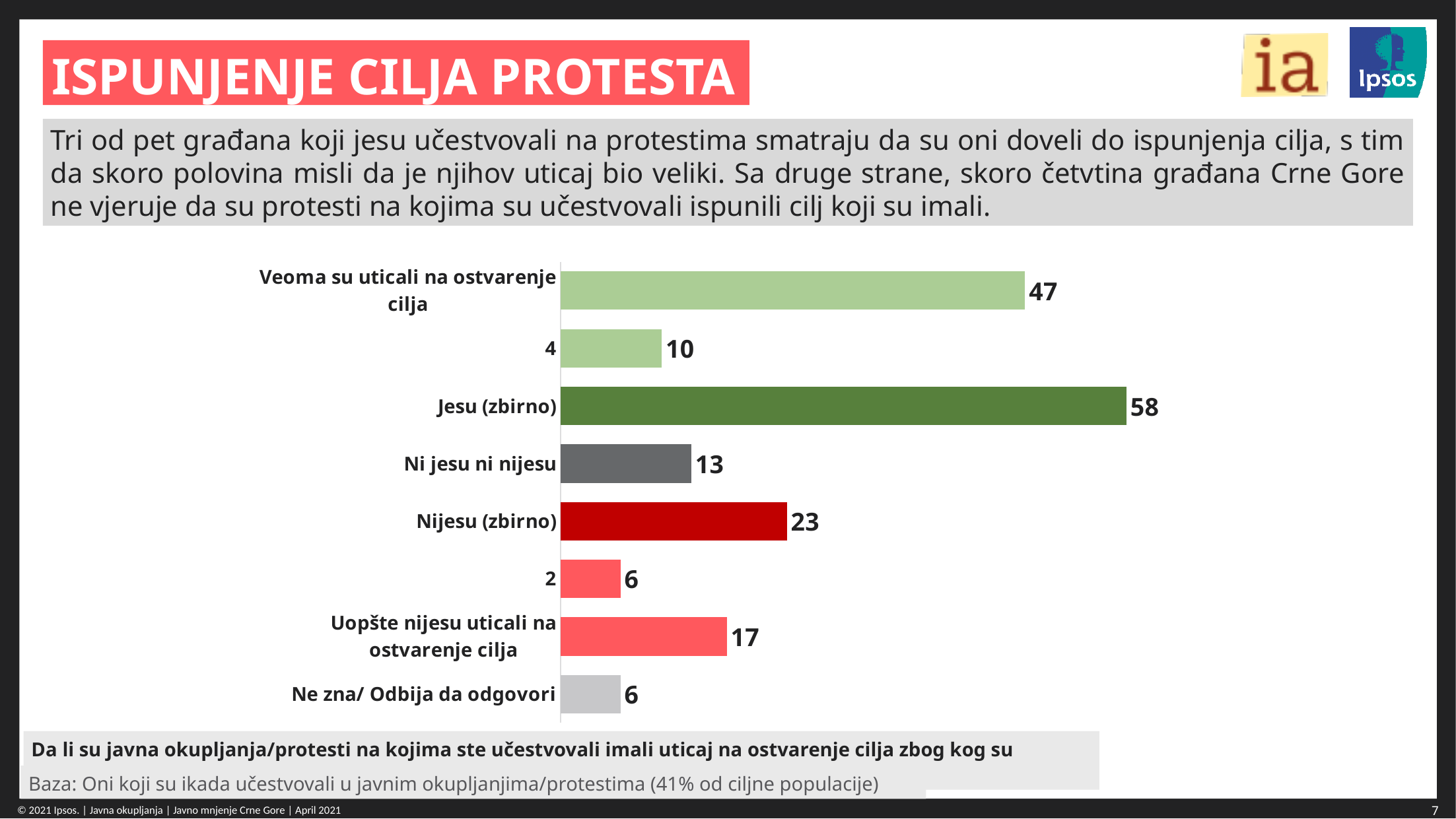
What is the value for "Ne zna/ Odbija da odgovori"? 6 How many bars does the chart show? 8 What colour is the bar for "Nijesu (zbirno)"? Dark red What is the value for "Uopšte nijesu uticali na ostvarenje cilja"? 17 What kind of chart is shown on the slide? Bar chart What is the difference between "Jesu (zbirno)" and "Nijesu (zbirno)"? 35 What is the value for "Jesu (zbirno)"? 58 What is the value for "Veoma su uticali na ostvarenje cilja"? 47 Which is larger, the value for "Ni jesu ni nijesu" or the value for "Uopšte nijesu uticali na ostvarenje cilja"? Uopšte nijesu uticali na ostvarenje cilja Which category has the highest value? Jesu (zbirno) What is the difference between "Veoma su uticali na ostvarenje cilja" and "Uopšte nijesu uticali na ostvarenje cilja"? 30 What is the value for "Ni jesu ni nijesu"? 13